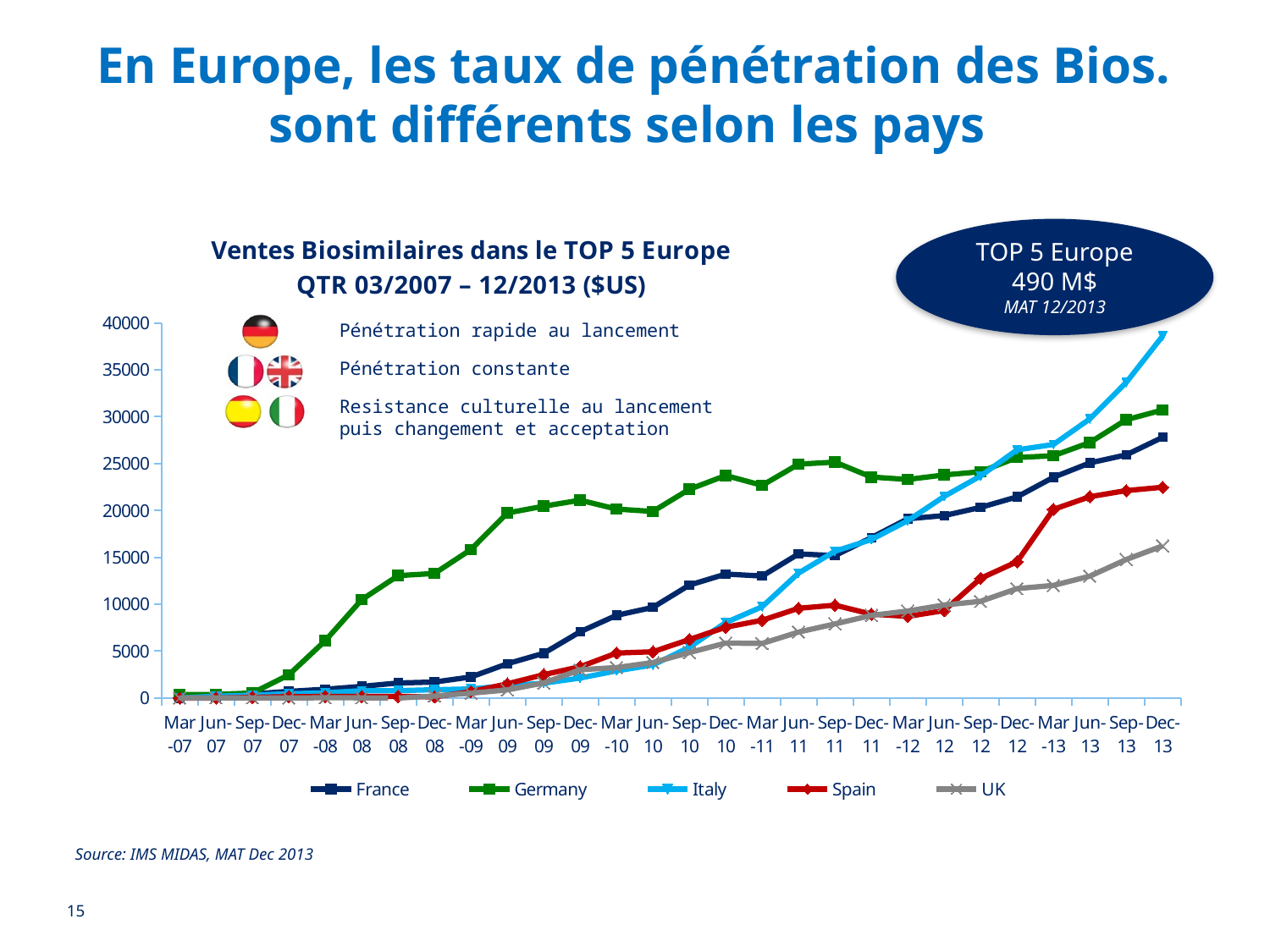
At Dec-09, which is larger, the value for Germany or the value for France? Germany What is the title of the chart? Ventes Biosimilaires dans le TOP 5 Europe QTR 03/2007 – 12/2013 ($US) Is the value for Italy at Dec-13 greater or less than 35000? greater Which country has the highest value at Dec-13? Italy Which country has the highest value at Dec-09? Germany What kind of chart is shown on the slide? line chart How many series does the legend list? 5 How many quarterly points are plotted along the x axis? 28 Does the Italy series rise or fall from Mar-07 to Dec-13? rise Is the value for UK at Dec-13 greater or less than 20000? less Which country has the lowest value at Dec-13? UK Is the value for France at Dec-13 greater or less than 25000? greater